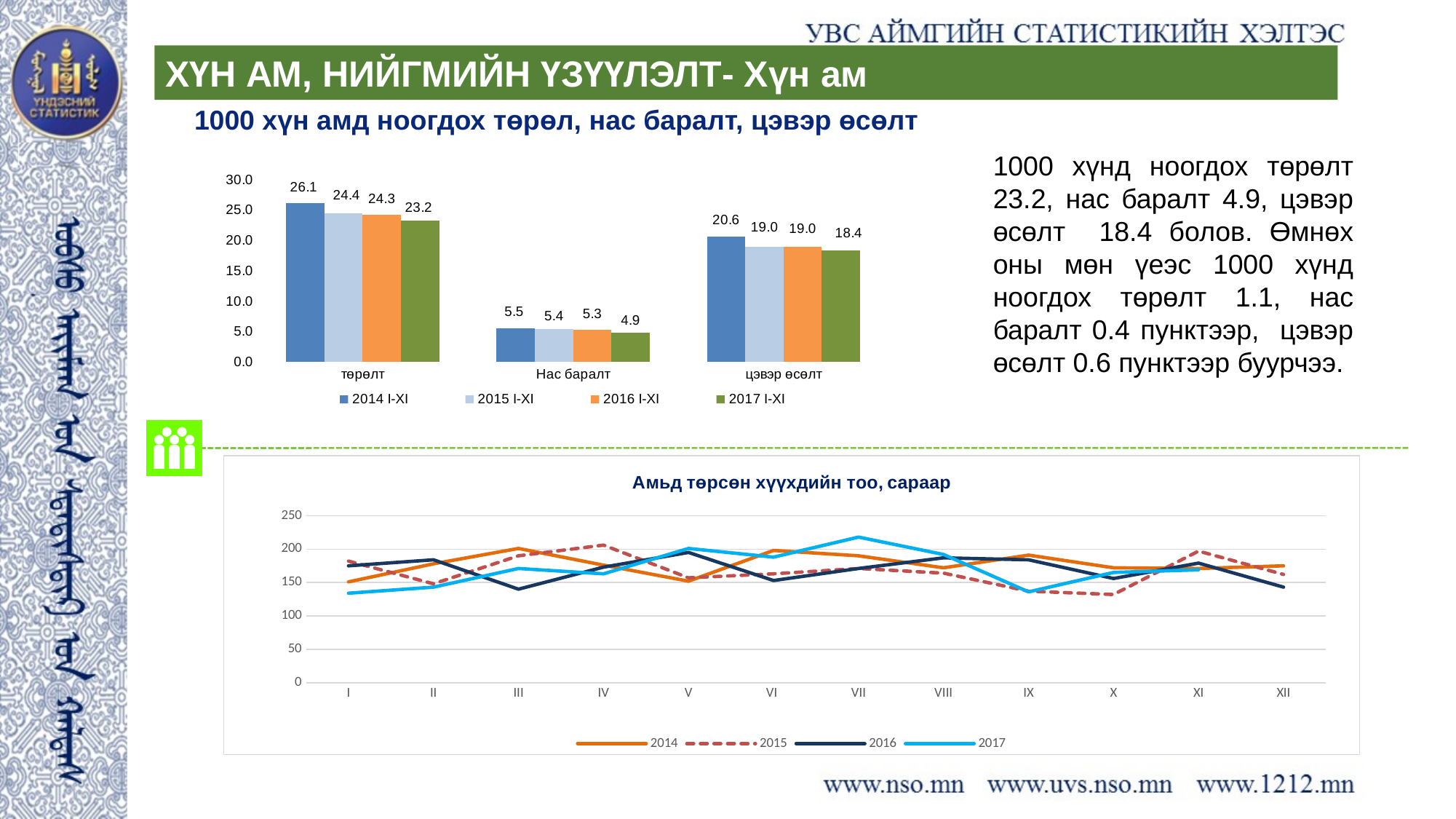
In the top bar chart, what is the value for Нас баралт in 2017 I-XI? 4.9 In the chart titled 'Амьд төрсөн хүүхдийн тоо, сараар', is the value for 2017 in month VII greater or less than 200? greater In the top bar chart, what is the difference between the төрөлт values for 2014 I-XI and 2017 I-XI? 2.9 In the top bar chart, which year has the lowest value for цэвэр өсөлт? 2017 I-XI In the top bar chart, which year has the highest value for төрөлт? 2014 I-XI In the top bar chart, what is the value for цэвэр өсөлт in 2015 I-XI? 19.0 In the top bar chart, what is the value for төрөлт in 2014 I-XI? 26.1 In the top bar chart, do the төрөлт values rise or fall from 2014 I-XI to 2017 I-XI? fall In the chart titled 'Амьд төрсөн хүүхдийн тоо, сараар', how many months are shown on the x axis? 12 In the top bar chart, how many series does the legend list? 4 In the chart titled 'Амьд төрсөн хүүхдийн тоо, сараар', is the value for 2017 in month I greater or less than 150? less What kind of chart is the chart titled 'Амьд төрсөн хүүхдийн тоо, сараар'? line chart